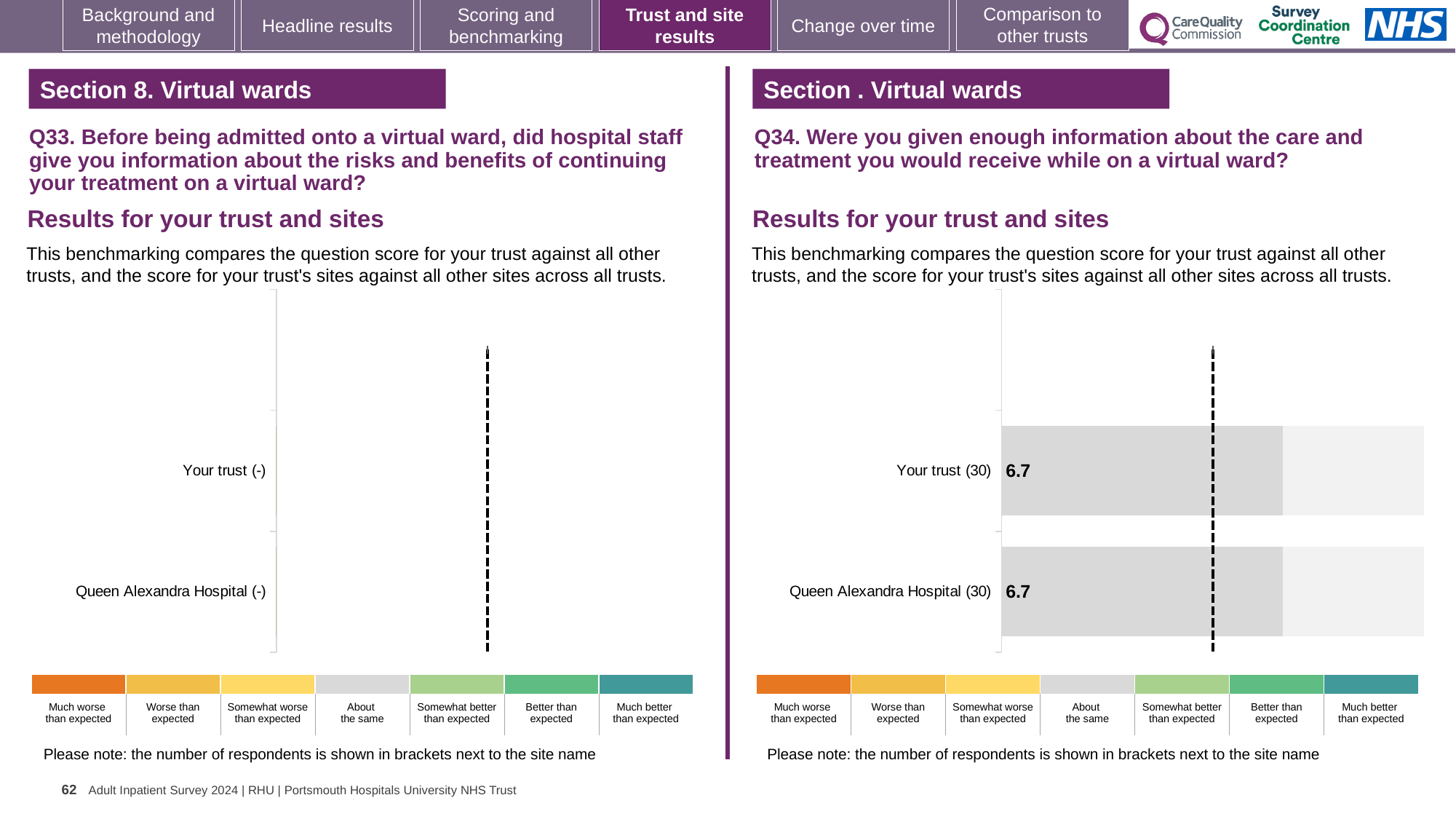
How many categories (rows) are plotted in the Q34 chart on the right? 2 In the colour key below the charts, which category is shown in grey? About the same How many categories (rows) are listed in the Q33 chart on the left? 2 In the Q33 chart on the left, what is shown in brackets next to Your trust? - How many benchmark categories does the colour key below each chart list? 7 In the Q34 chart on the right, how many respondents are shown in brackets next to Queen Alexandra Hospital? 30 In the Q34 chart on the right, what is the score for Queen Alexandra Hospital? 6.7 In the Q34 chart on the right, how many respondents are shown in brackets next to Your trust? 30 In the Q34 chart on the right, what is the score for Your trust? 6.7 What kind of chart is used for the Q34 results on the right? Bar chart In the Q34 chart on the right, what is the difference between the score for Your trust and the score for Queen Alexandra Hospital? 0